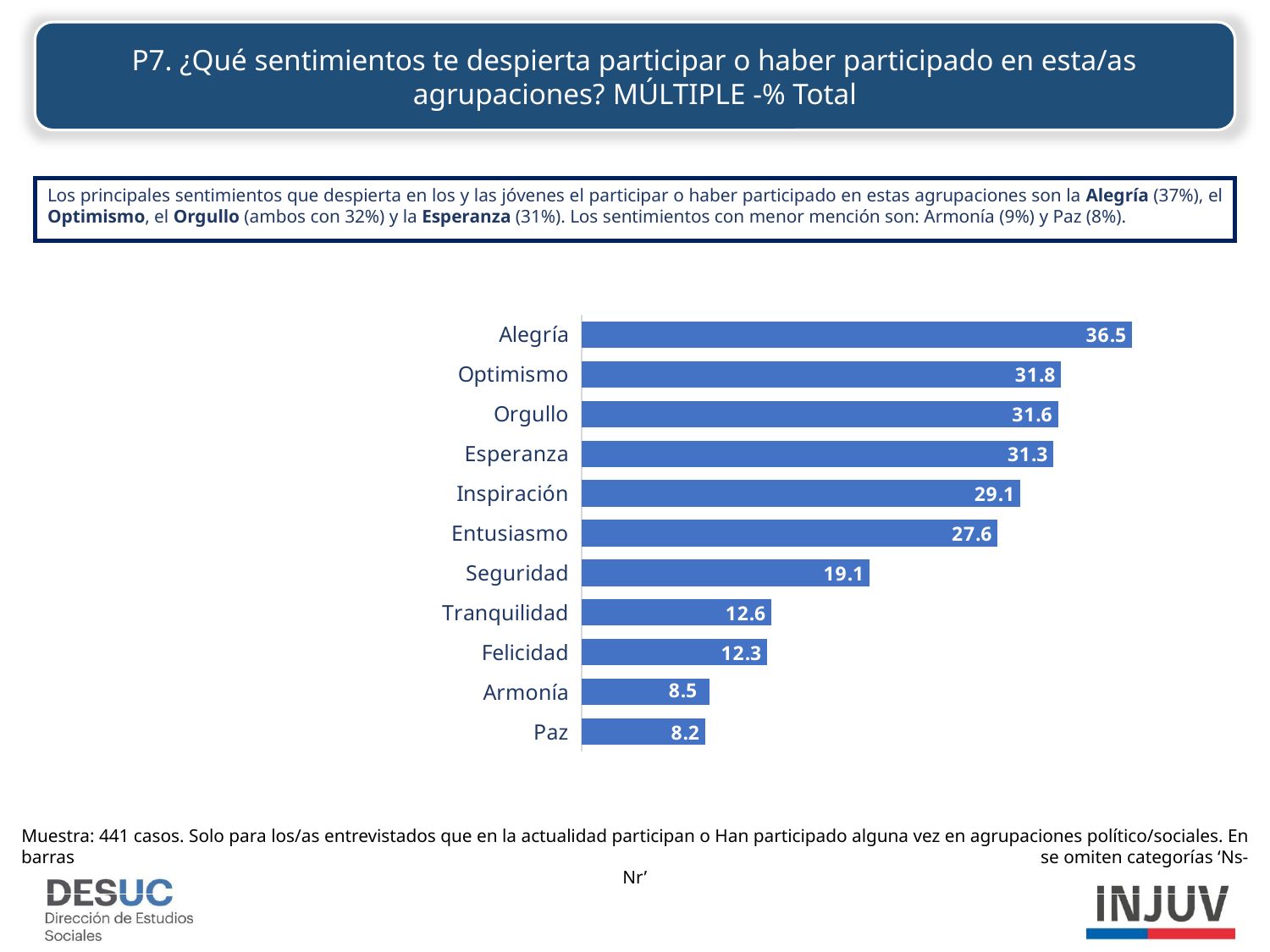
What is the difference between the values for Alegría and Paz? 28.3 What kind of chart is shown on the slide? Bar chart Do the values increase or decrease going from the top bar to the bottom bar? Decrease What is the value for Felicidad? 12.3 What is the value for Alegría? 36.5 Which category has the lowest value? Paz Which category has the highest value? Alegría Which is larger, the value for Entusiasmo or the value for Esperanza? Esperanza What is the difference between the values for Inspiración and Entusiasmo? 1.5 How many categories are shown in the chart? 11 What is the value for Seguridad? 19.1 Which is larger, the value for Seguridad or the value for Tranquilidad? Seguridad